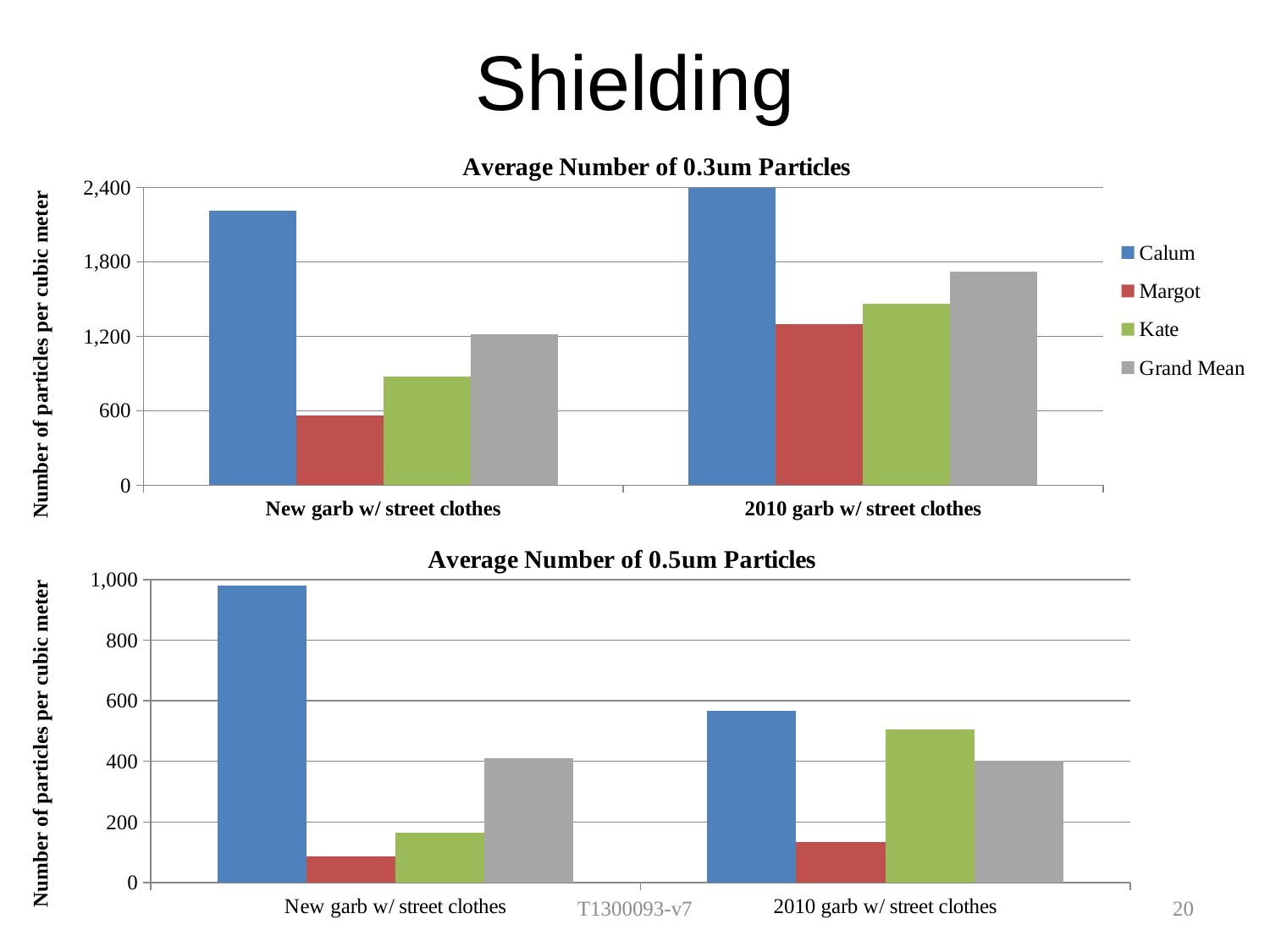
In the 'Average Number of 0.5um Particles' chart, is the value for Calum under 'New garb w/ street clothes' greater or less than 800? greater In the 'Average Number of 0.3um Particles' chart, for '2010 garb w/ street clothes', which is larger: Kate or Margot? Kate In the 'Average Number of 0.5um Particles' chart, which series has the highest value for 'New garb w/ street clothes'? Calum How many series does the legend of the 'Average Number of 0.3um Particles' chart list? 4 What kind of chart is the 'Average Number of 0.3um Particles' chart? bar chart In the 'Average Number of 0.3um Particles' chart, which series has the highest value for 'New garb w/ street clothes'? Calum How many categories are shown on the x axis of the 'Average Number of 0.5um Particles' chart? 2 What is the y-axis title of the 'Average Number of 0.5um Particles' chart? Number of particles per cubic meter In the 'Average Number of 0.5um Particles' chart, is the value for Margot under 'New garb w/ street clothes' greater or less than 200? less In the 'Average Number of 0.3um Particles' chart, is the value for Calum under 'New garb w/ street clothes' greater or less than 1,800? greater In the 'Average Number of 0.3um Particles' chart, which series has the lowest value for 'New garb w/ street clothes'? Margot